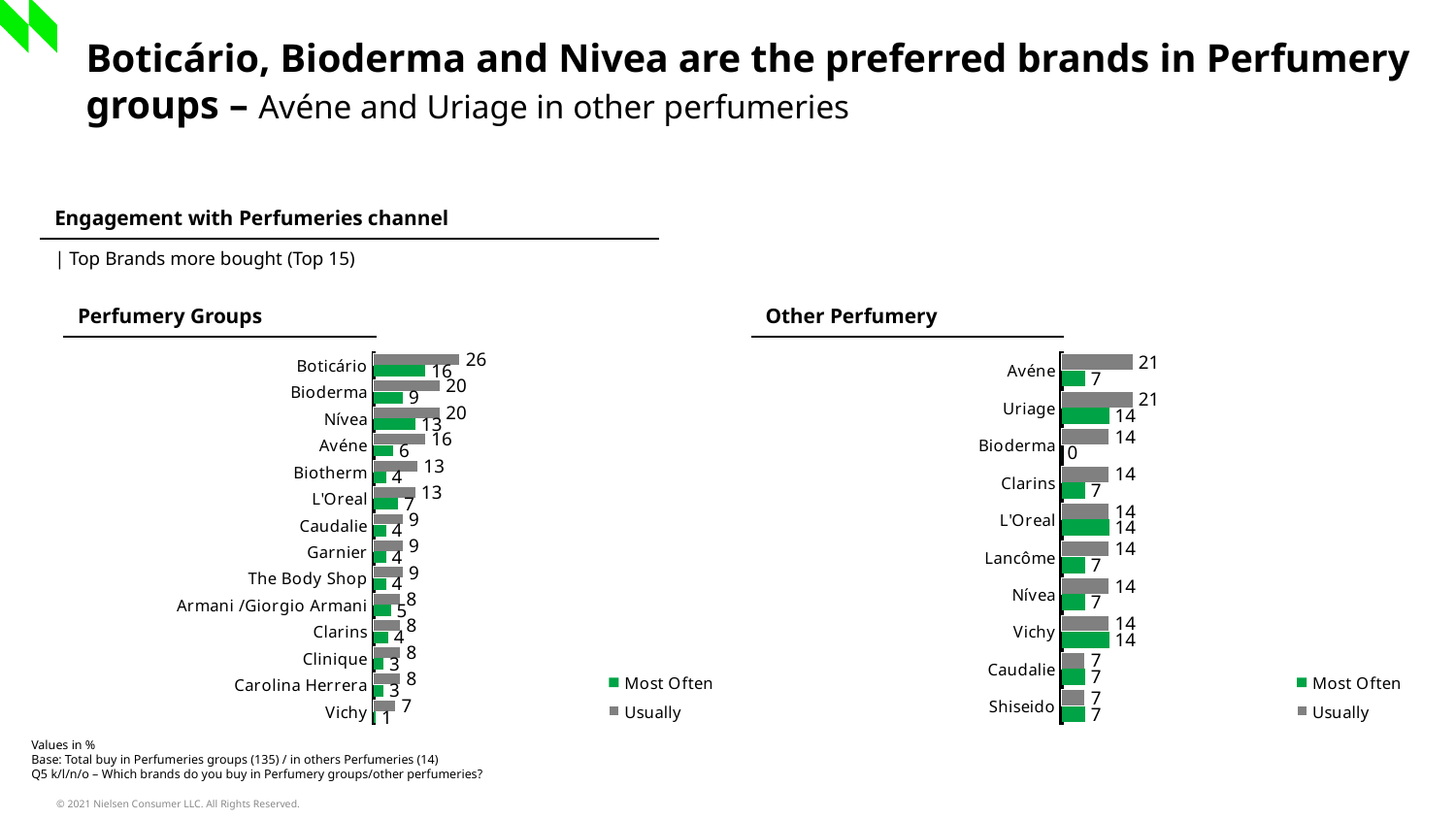
In the Perfumery Groups chart, what is the difference between the Usually and Most Often values for Boticário? 10 What type of chart is the Perfumery Groups chart? Bar chart How many series does the legend of the Perfumery Groups chart list? 2 In the Other Perfumery chart, what is the Most Often value for Uriage? 14 In the Perfumery Groups chart, what is the Usually value for Boticário? 26 In the Perfumery Groups chart, which brand has the highest Usually value? Boticário In the Other Perfumery chart, what is the Most Often value for Bioderma? 0 In the Other Perfumery chart, which is larger: the Most Often value for Uriage or the Most Often value for Avéne? Uriage How many brands are shown in the Other Perfumery chart? 10 In the Perfumery Groups chart, which brand has the lowest Most Often value? Vichy In the Other Perfumery chart, what is the difference between the Usually and Most Often values for Avéne? 14 In the Perfumery Groups chart, what is the Most Often value for Nívea? 13